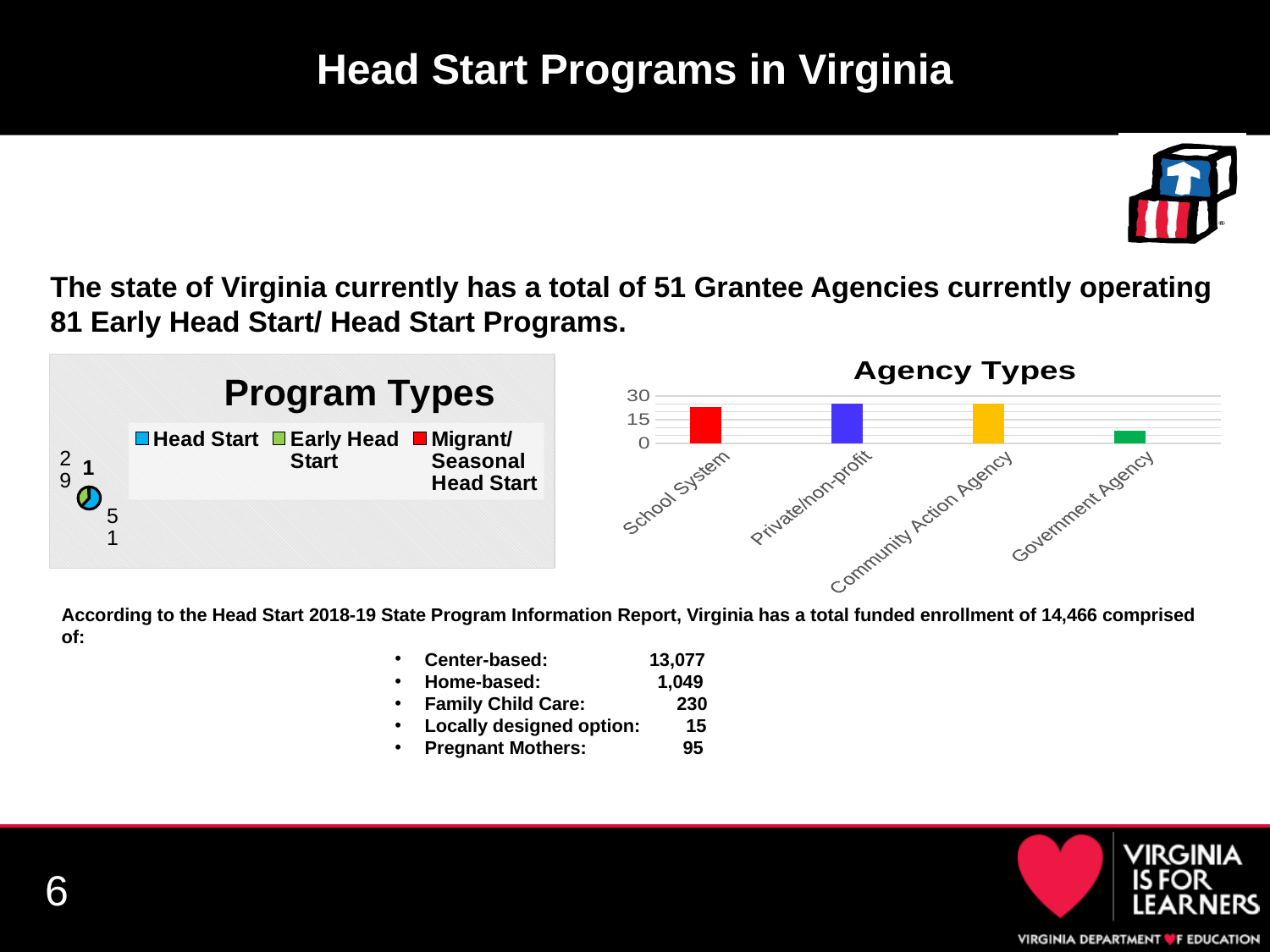
In the Agency Types chart, which category has the lowest value? Government Agency In the Agency Types chart, what colour is the bar for School System? red In the Agency Types chart, which is larger: School System or Government Agency? School System In the Agency Types chart, is the value for Community Action Agency greater or less than 15? greater How many categories are shown on the x axis of the Agency Types chart? 4 In the Agency Types chart, is the value for Government Agency greater or less than 15? less In the Agency Types chart, is the value for Private/non-profit greater or less than 15? greater What kind of chart is the Agency Types chart? bar chart What kind of chart is the Program Types chart? pie chart How many entries does the legend of the Program Types chart list? 3 In the Program Types chart, which legend entry is shown in red? Migrant/Seasonal Head Start